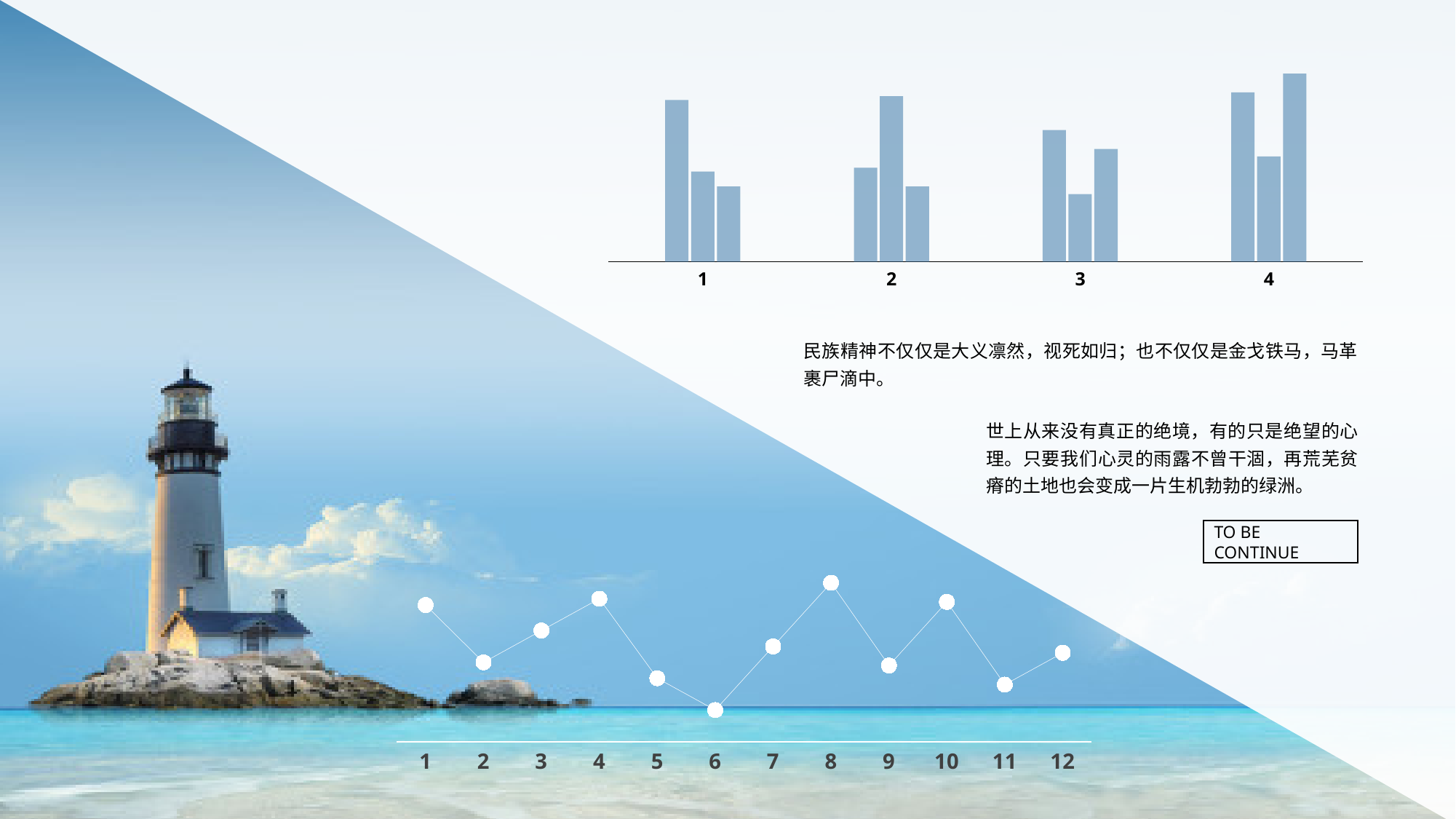
On the bottom line chart, is the value at point 1 higher or lower than the value at point 2? higher On the bottom line chart, which x-axis point has the highest value? 8 How many points are plotted on the bottom line chart? 12 How many bars are shown for each category in the top bar chart? 3 On the bottom line chart, which x-axis point has the lowest value? 6 On the bottom line chart, do the values rise or fall from point 6 to point 8? rise In the top bar chart, which of the three bars in category 1 is the shortest? the third bar In the top bar chart, which of the three bars in category 2 is the tallest? the middle bar What kind of chart is the chart at the top of the slide? bar chart What kind of chart is the chart at the bottom of the slide? line chart In the top bar chart, which category contains the tallest bar overall? 4 How many categories are shown on the x axis of the top bar chart? 4